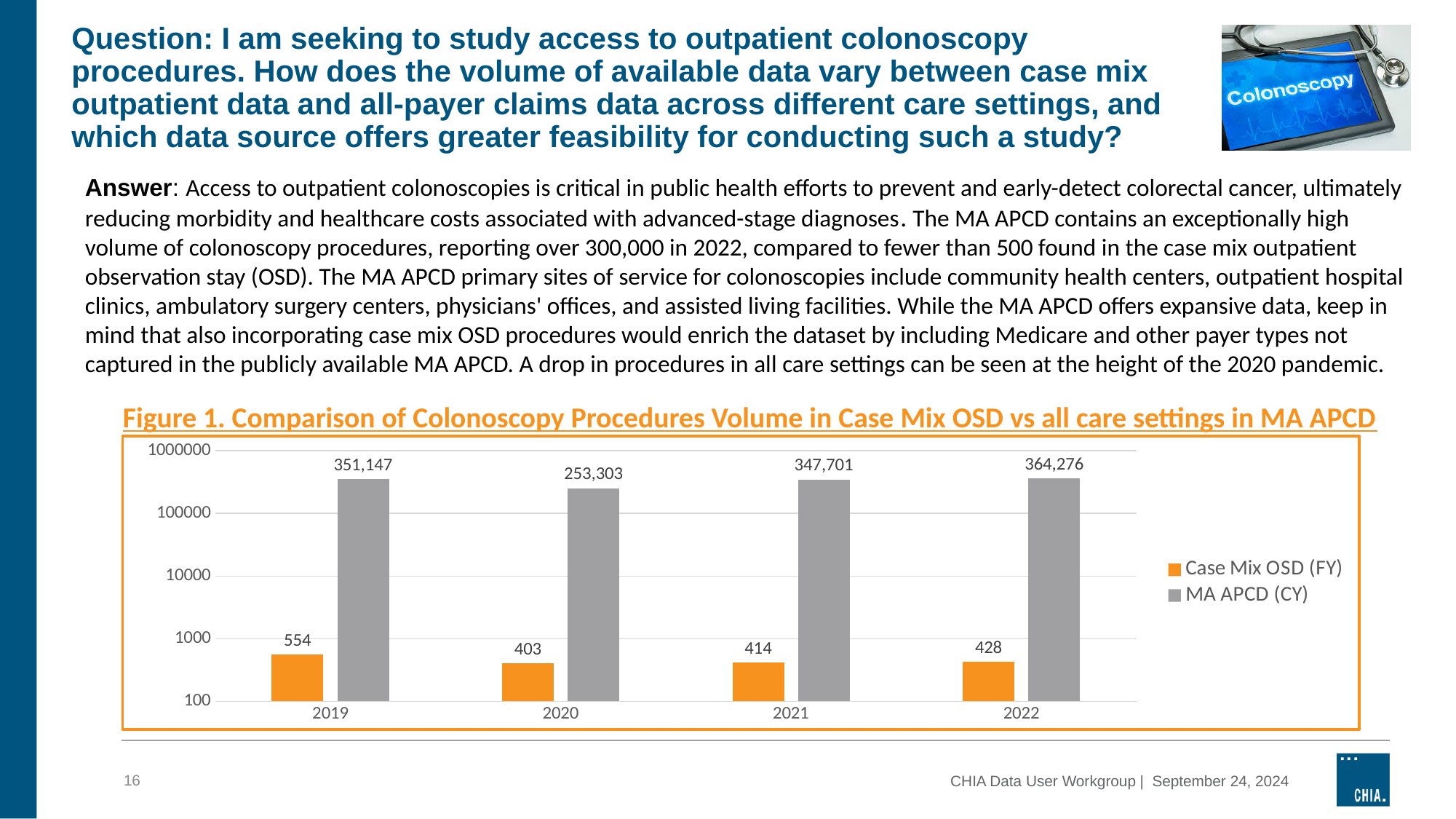
Which year has the lowest MA APCD (CY) value? 2020 What is the difference between the Case Mix OSD (FY) values for 2019 and 2020? 151 What is the MA APCD (CY) value for 2019? 351,147 What is the difference between the MA APCD (CY) values for 2022 and 2021? 16,575 Which is larger, the Case Mix OSD (FY) value for 2021 or for 2022? 2022 How many years are shown on the x axis? 4 How many series does the legend list? 2 What is the MA APCD (CY) value for 2022? 364,276 Is the Case Mix OSD (FY) value for 2019 greater or less than 1000? less Which year has the highest Case Mix OSD (FY) value? 2019 What kind of chart is shown in Figure 1? bar chart What is the Case Mix OSD (FY) value for 2020? 403